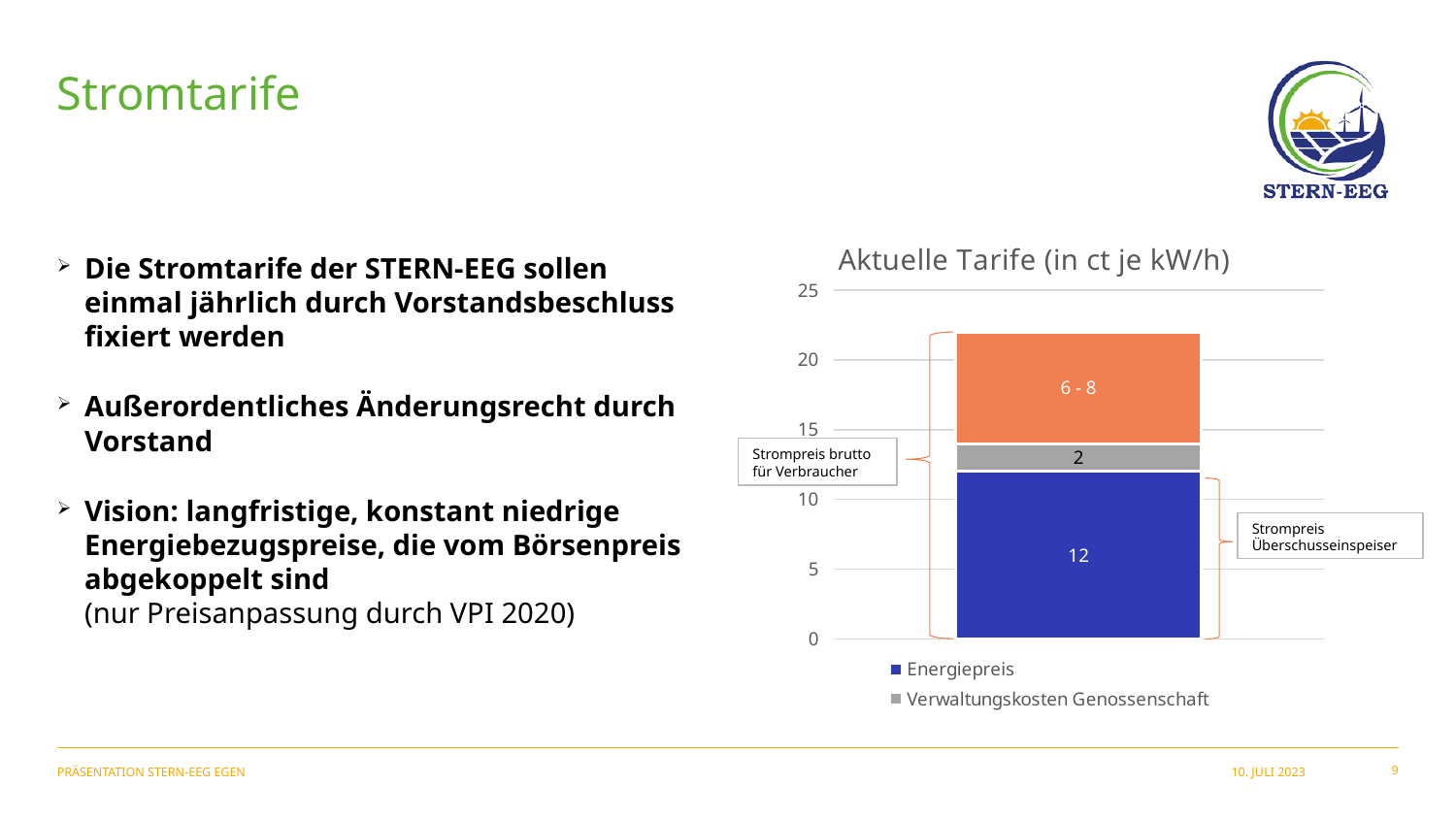
What is the combined value of the Energiepreis and Verwaltungskosten Genossenschaft segments? 14 What is the value of the Verwaltungskosten Genossenschaft segment in the stacked bar? 2 What is the title of the chart? Aktuelle Tarife (in ct je kW/h) What kind of chart is shown on the slide? bar chart Which segment of the stacked bar has the largest value? Energiepreis Is the top of the stacked bar greater or less than 20? greater How many series does the chart legend list? 2 What is the value of the Energiepreis segment in the stacked bar? 12 Which is larger, the Energiepreis segment or the Verwaltungskosten Genossenschaft segment? Energiepreis What data label is printed on the top (orange) segment of the stacked bar? 6 - 8 How many stacked bars are plotted in the chart? 1 What is the difference between the Energiepreis segment and the Verwaltungskosten Genossenschaft segment? 10